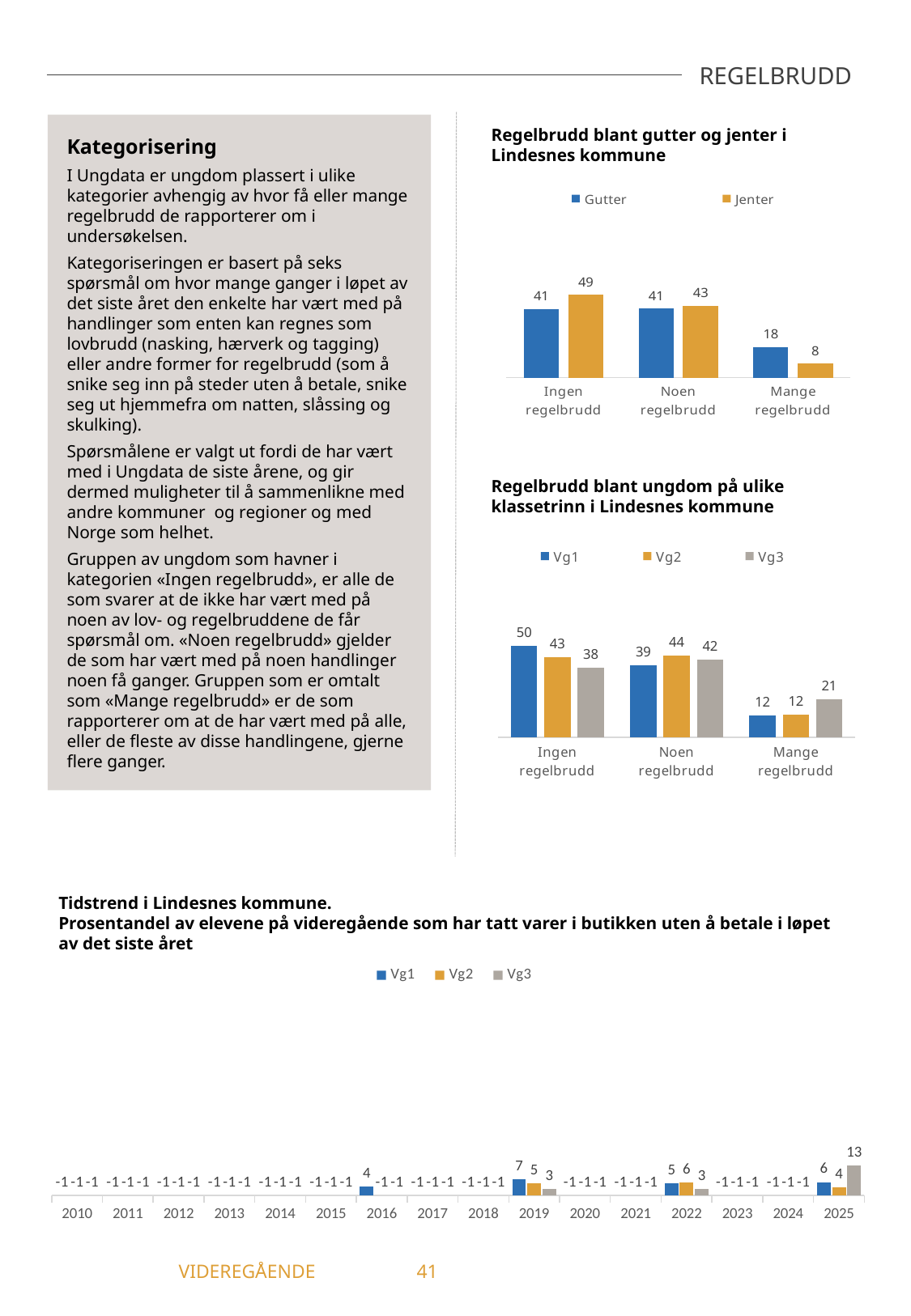
In the chart 'Regelbrudd blant ungdom på ulike klassetrinn i Lindesnes kommune', which series has the highest value in the 'Mange regelbrudd' category? Vg3 In the chart 'Tidstrend i Lindesnes kommune', what is the value for Vg1 in 2019? 7 In the chart 'Regelbrudd blant ungdom på ulike klassetrinn i Lindesnes kommune', how many categories are shown on the x axis? 3 In the chart 'Regelbrudd blant gutter og jenter i Lindesnes kommune', what is the value for Gutter in the 'Mange regelbrudd' category? 18 What kind of chart is 'Regelbrudd blant ungdom på ulike klassetrinn i Lindesnes kommune'? Bar chart In the chart 'Regelbrudd blant gutter og jenter i Lindesnes kommune', how many series does the legend list? 2 In the chart 'Tidstrend i Lindesnes kommune', which series has the lowest value in 2022? Vg3 In the chart 'Regelbrudd blant gutter og jenter i Lindesnes kommune', what is the difference between Gutter and Jenter in the 'Mange regelbrudd' category? 10 In the chart 'Tidstrend i Lindesnes kommune', what is the value for Vg3 in 2025? 13 In the chart 'Regelbrudd blant gutter og jenter i Lindesnes kommune', what is the value for Jenter in the 'Ingen regelbrudd' category? 49 In the chart 'Regelbrudd blant ungdom på ulike klassetrinn i Lindesnes kommune', what is the value for Vg1 in the 'Ingen regelbrudd' category? 50 In the chart 'Regelbrudd blant ungdom på ulike klassetrinn i Lindesnes kommune', which is larger in the 'Noen regelbrudd' category, Vg1 or Vg2? Vg2